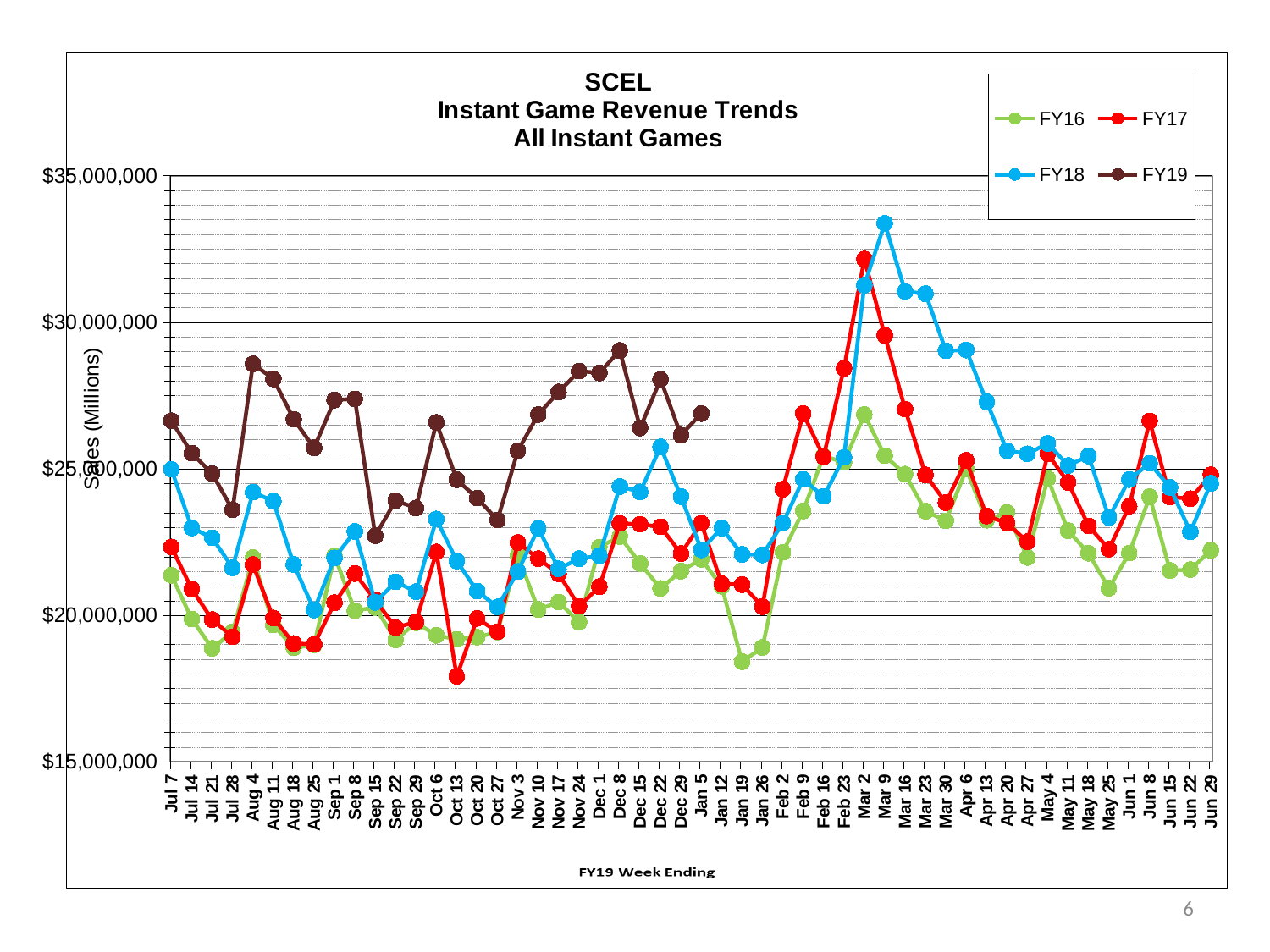
Which series reaches the highest value anywhere on the chart? FY18 Is the FY17 value for the week ending Oct 13 greater or less than $20,000,000? less Is the FY18 value for the week ending Mar 9 greater or less than $30,000,000? greater Which series is drawn in red? FY17 Is the FY19 value for the week ending Sep 15 greater or less than $25,000,000? less How many series does the legend list? 4 For the week ending Mar 9, which series has the larger value, FY17 or FY18? FY18 What is the title of the x axis? FY19 Week Ending How many week-ending categories are shown along the x axis? 52 What kind of chart is shown on the slide? Line chart